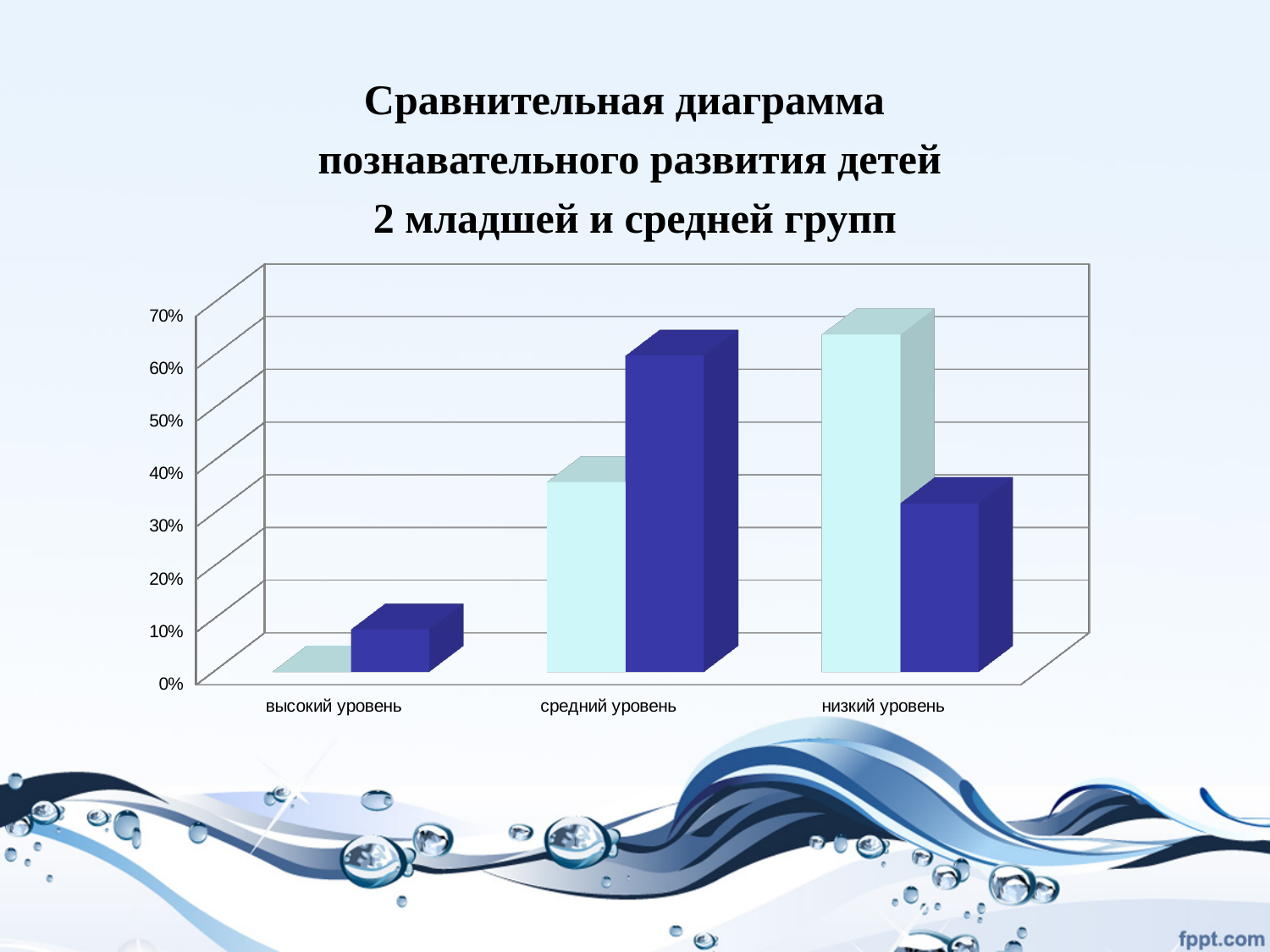
Is the dark blue bar for высокий уровень greater or less than 20%? less Which category has the shortest light-coloured bar? высокий уровень For средний уровень, which bar is taller, the light-coloured one or the dark blue one? dark blue Which category has the tallest dark blue bar? средний уровень Which category has the shortest dark blue bar? высокий уровень What kind of chart is shown on the slide? bar chart How many bars are shown for each category in the chart? 2 Which category has the tallest light-coloured bar? низкий уровень For низкий уровень, which bar is taller, the light-coloured one or the dark blue one? light-coloured What is the title of the chart? Сравнительная диаграмма познавательного развития детей 2 младшей и средней групп Is the dark blue bar for средний уровень greater or less than 50%? greater How many categories are shown on the x axis of the chart? 3